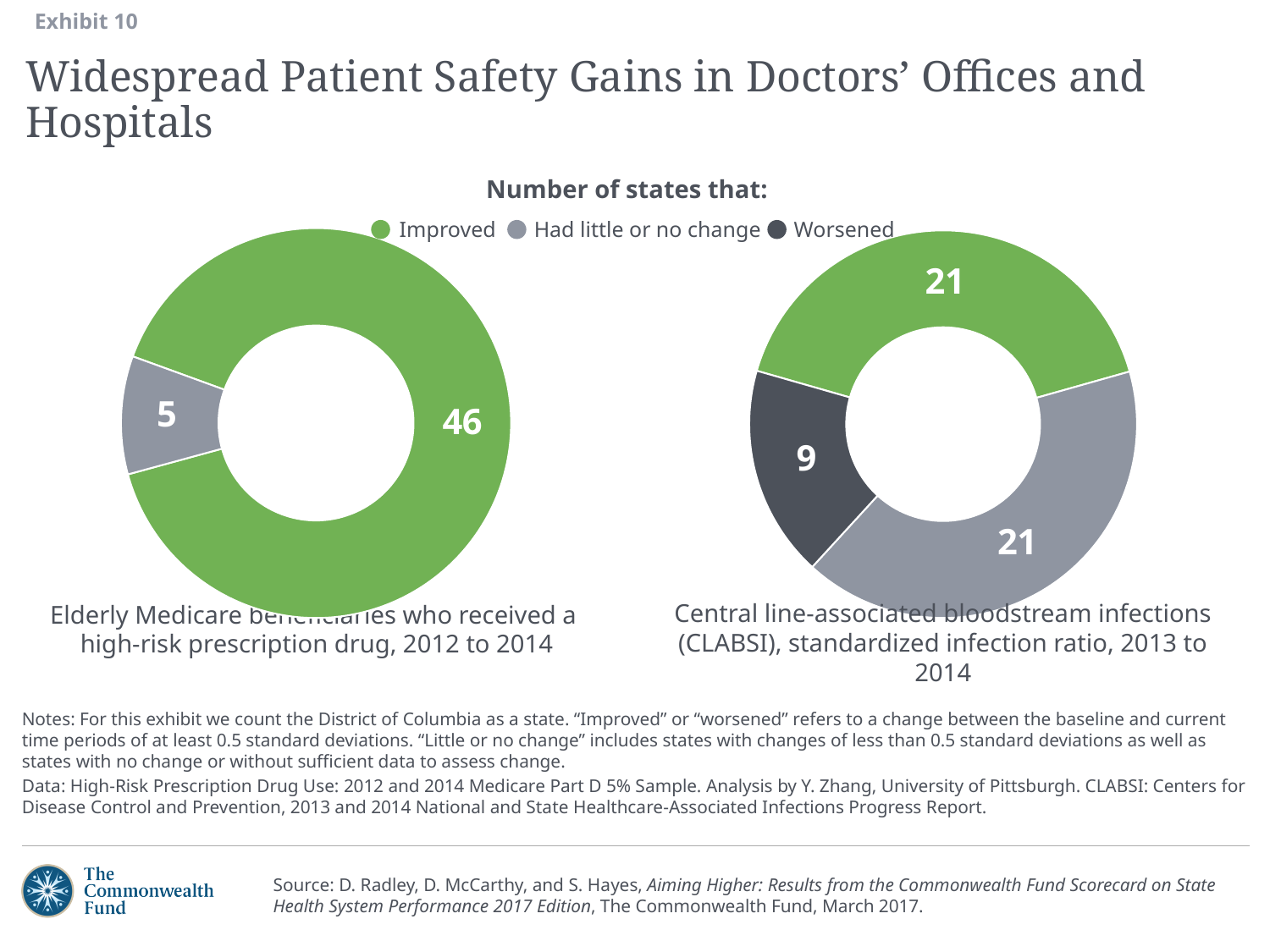
In the right chart (Central line-associated bloodstream infections, 2013 to 2014), how many states worsened? 9 In the right chart (CLABSI), which category has the smallest number of states? Worsened In the left chart (Elderly Medicare beneficiaries who received a high-risk prescription drug, 2012 to 2014), how many states had little or no change? 5 What kind of charts are shown on the slide? Donut (pie) charts Which chart has more states that improved, the left chart (high-risk prescription drug) or the right chart (CLABSI)? The left chart (high-risk prescription drug) How many categories does the legend list for these charts? 3 In the right chart (CLABSI, 2013 to 2014), how many states had little or no change? 21 In the right chart (Central line-associated bloodstream infections, 2013 to 2014), how many states improved? 21 In the left chart (high-risk prescription drug), what is the difference between the number of states that improved and the number that had little or no change? 41 In the right chart (CLABSI), what is the difference between the number of states that improved and the number that worsened? 12 In the left chart (Elderly Medicare beneficiaries who received a high-risk prescription drug, 2012 to 2014), how many states improved? 46 In the left chart (high-risk prescription drug), which category has the largest number of states? Improved